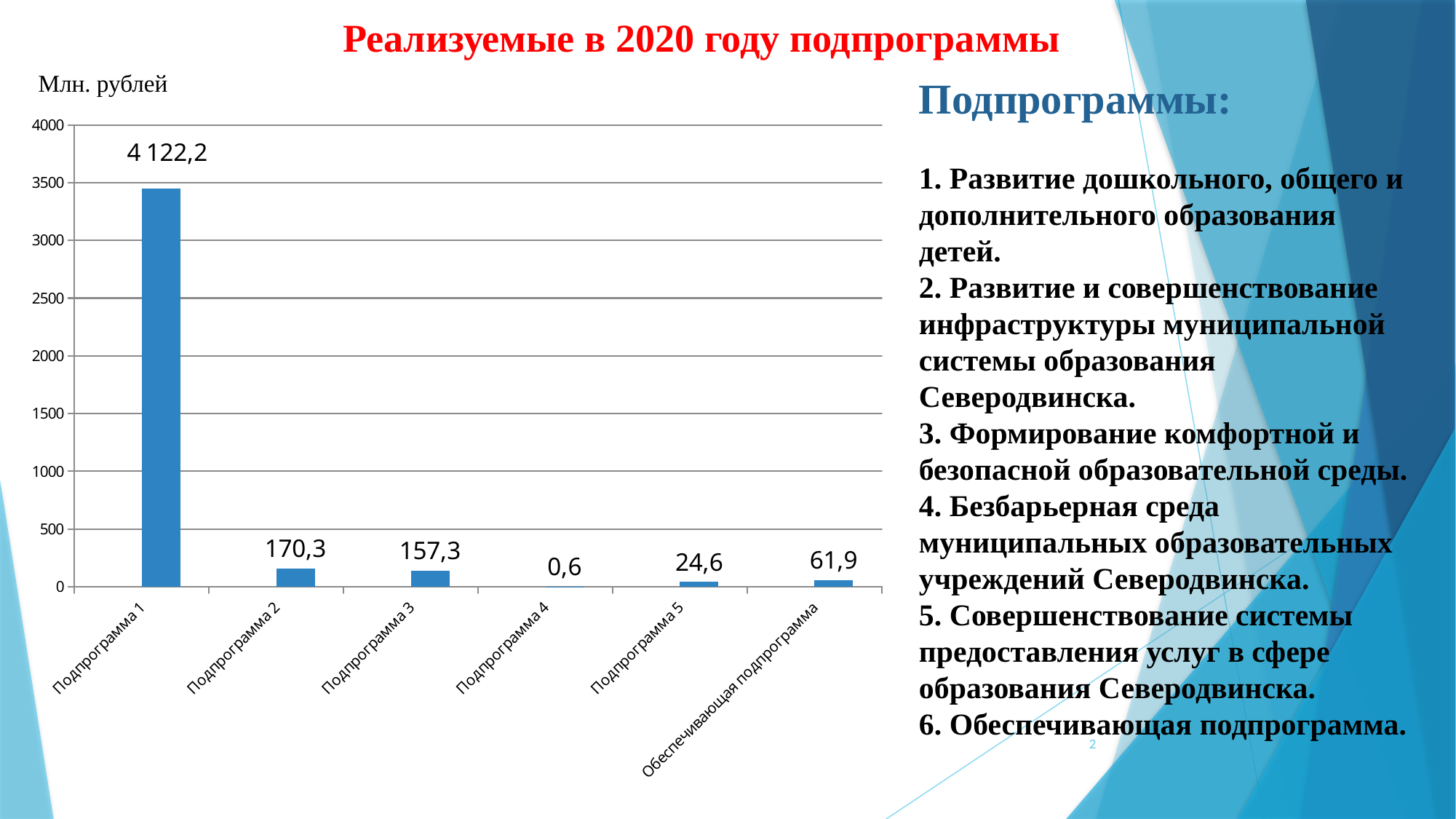
What kind of chart is shown on the slide? Bar chart What is the value for Подпрограмма 1? 4 122,2 What unit is given for the vertical axis of the chart? Млн. рублей Which category has the highest value? Подпрограмма 1 What is the value for Подпрограмма 4? 0,6 What is the value for Обеспечивающая подпрограмма? 61,9 What is the difference between the values for Подпрограмма 2 and Подпрограмма 3? 13 How many categories are shown on the x axis of the chart? 6 Which category has the lowest value? Подпрограмма 4 What is the value for Подпрограмма 2? 170,3 What is the difference between the values for Обеспечивающая подпрограмма and Подпрограмма 5? 37,3 Which is larger, the value for Подпрограмма 5 or the value for Обеспечивающая подпрограмма? Обеспечивающая подпрограмма